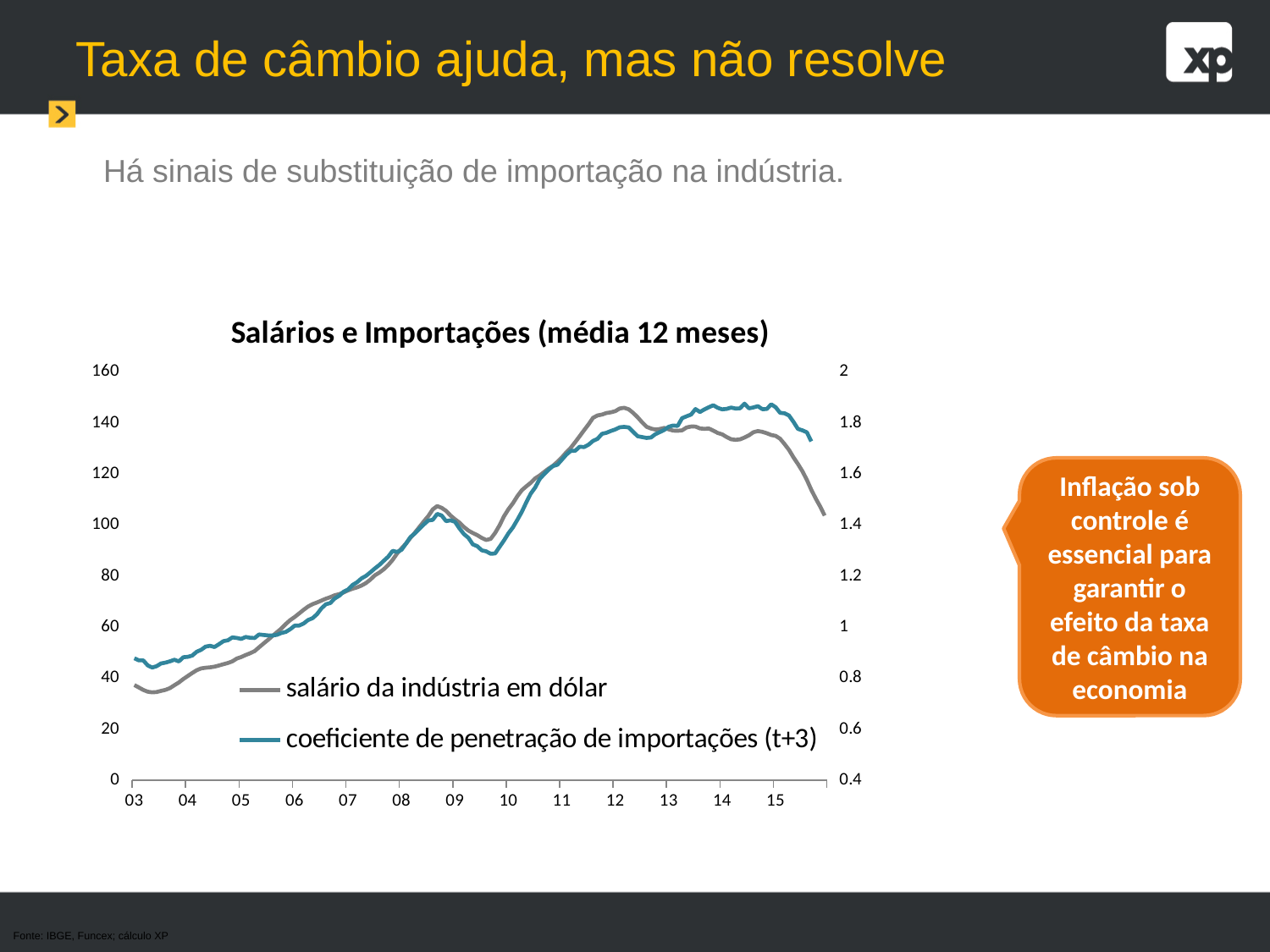
Is the value of 'coeficiente de penetração de importações (t+3)' at 14 greater or less than 1.6 on the right axis? greater Is the value of 'coeficiente de penetração de importações (t+3)' at 03 greater or less than 1 on the right axis? less Which series is drawn in grey in the chart? salário da indústria em dólar Does the 'coeficiente de penetração de importações (t+3)' series rise or fall from 14 to the end of the chart? fall What kind of chart is shown on the slide? line chart Does the 'salário da indústria em dólar' series rise or fall between 03 and 12? rise How many series does the legend of the chart list? 2 Does the 'salário da indústria em dólar' series rise or fall from 12 to the end of the chart? fall Is the value of 'salário da indústria em dólar' at 03 greater or less than 60 on the left axis? less What is the title of the chart? Salários e Importações (média 12 meses) How many year labels are shown on the x axis of the chart? 13